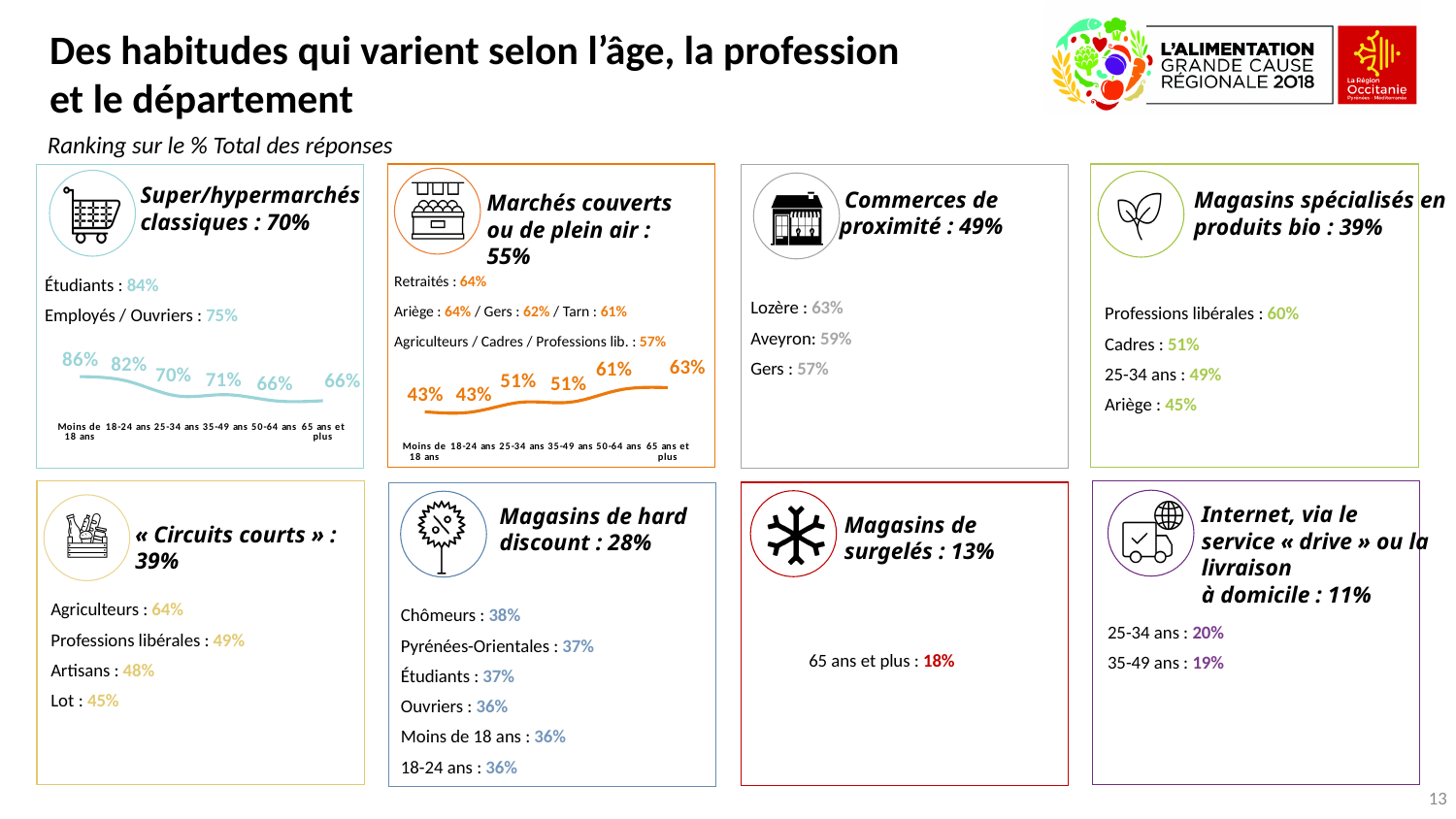
In the Super/hypermarchés classiques chart, what is the value for 'Moins de 18 ans'? 86% In the Super/hypermarchés classiques chart, which age group has the highest value? Moins de 18 ans In the Super/hypermarchés classiques chart, what is the value for '35-49 ans'? 71% In the Marchés couverts ou de plein air chart, what is the value for '25-34 ans'? 51% In the Marchés couverts ou de plein air chart, what is the value for '65 ans et plus'? 63% In the Marchés couverts ou de plein air chart, which age group has the highest value? 65 ans et plus In the Marchés couverts ou de plein air chart, what is the difference between the values for '50-64 ans' and '18-24 ans'? 18% What type of chart is used in the Marchés couverts ou de plein air box? line chart In the Super/hypermarchés classiques chart, do the values generally rise or fall from the youngest to the oldest age group? fall In the Super/hypermarchés classiques chart, what is the difference between the values for '18-24 ans' and '25-34 ans'? 12% How many age groups are plotted in the Super/hypermarchés classiques chart? 6 In the Marchés couverts ou de plein air chart, do the values generally rise or fall from the youngest to the oldest age group? rise